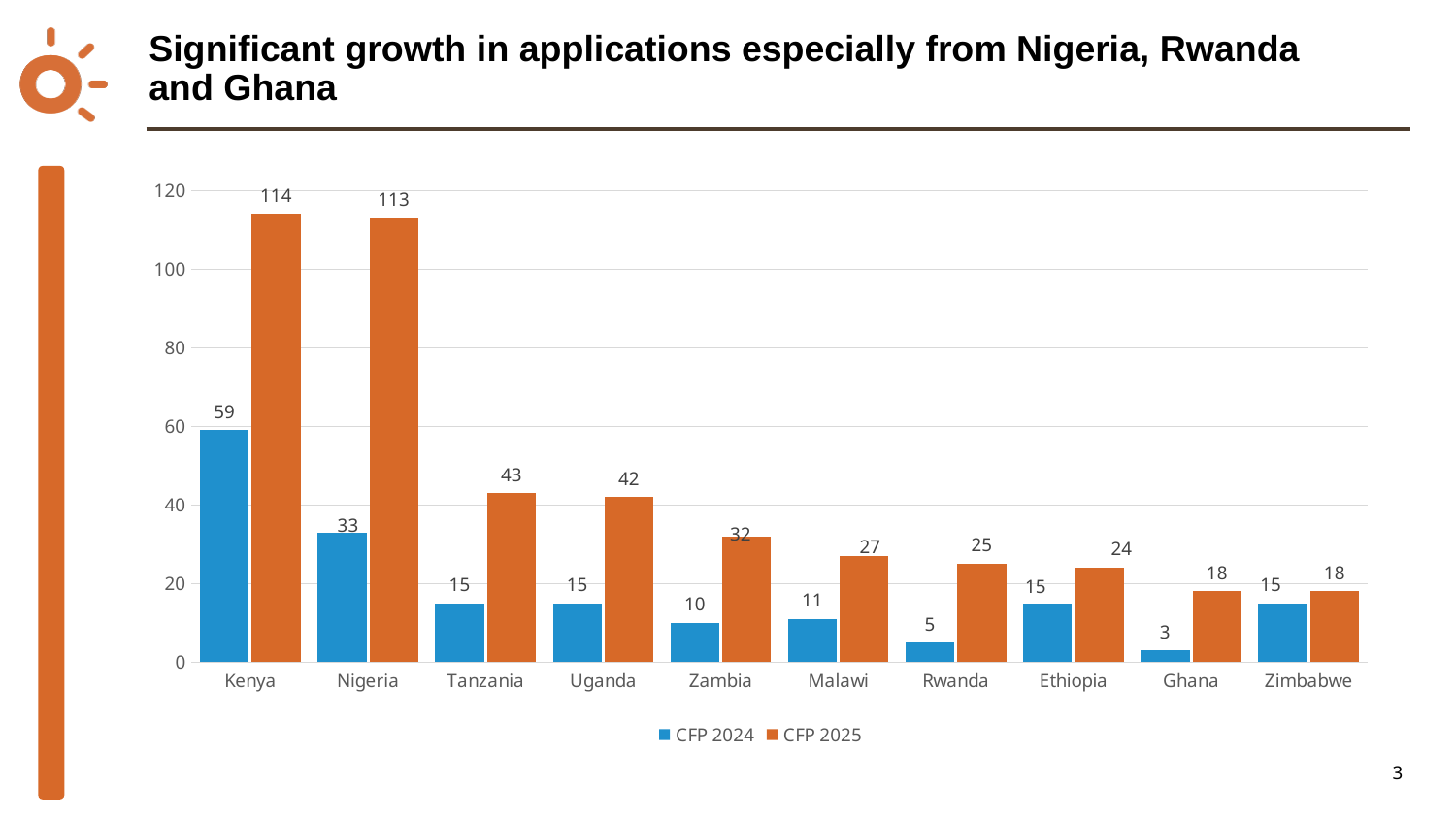
What is the CFP 2025 value for Ghana? 18 Which is larger for Rwanda: the CFP 2024 value or the CFP 2025 value? CFP 2025 How many countries are shown on the x axis? 10 How many series does the legend list? 2 What is the CFP 2025 value for Kenya? 114 What is the difference between the CFP 2025 and CFP 2024 values for Nigeria? 80 What is the difference between the CFP 2025 values for Kenya and Nigeria? 1 Which colour represents the CFP 2025 series? Orange What kind of chart is shown on the slide? Bar chart Which country has the highest CFP 2025 value? Kenya Which country has the lowest CFP 2024 value? Ghana What is the CFP 2024 value for Nigeria? 33